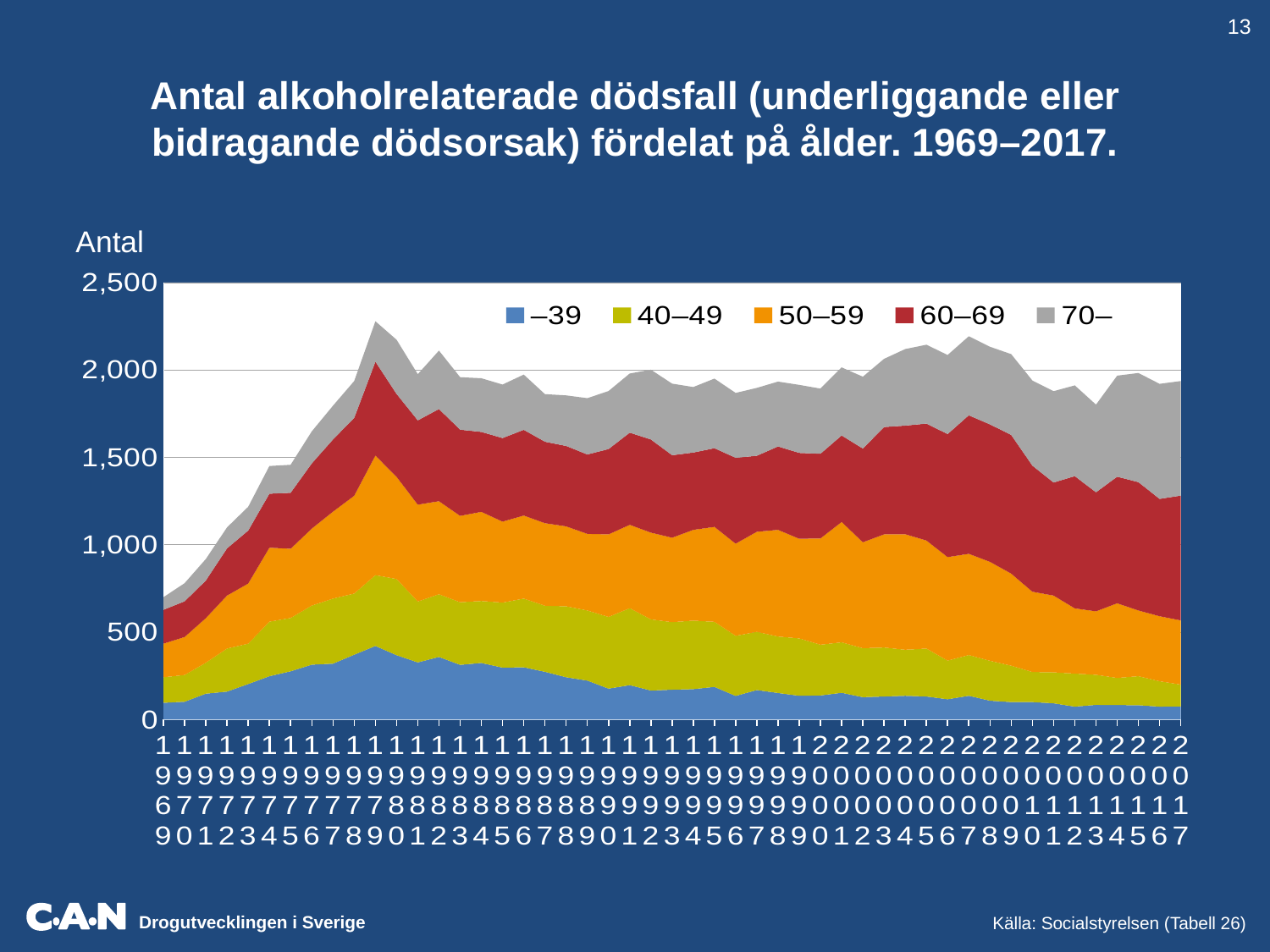
Is the total number of deaths in 1969 greater or less than 1,000? less In which year does the total number of deaths reach its highest point? 1979 Is the total number of deaths in 2017 greater or less than 1,500? greater Is the total number of deaths in 1979 greater or less than 2,000? greater What is the label on the y axis? Antal Which age groups are listed in the legend? –39, 40–49, 50–59, 60–69, 70– How many series does the legend list? 5 What kind of chart is shown on the slide? Stacked area chart How many years are plotted along the x axis? 49 Which age group has the smallest number of deaths in 2017? –39 Does the total number of deaths rise or fall between 1969 and 1979? rise